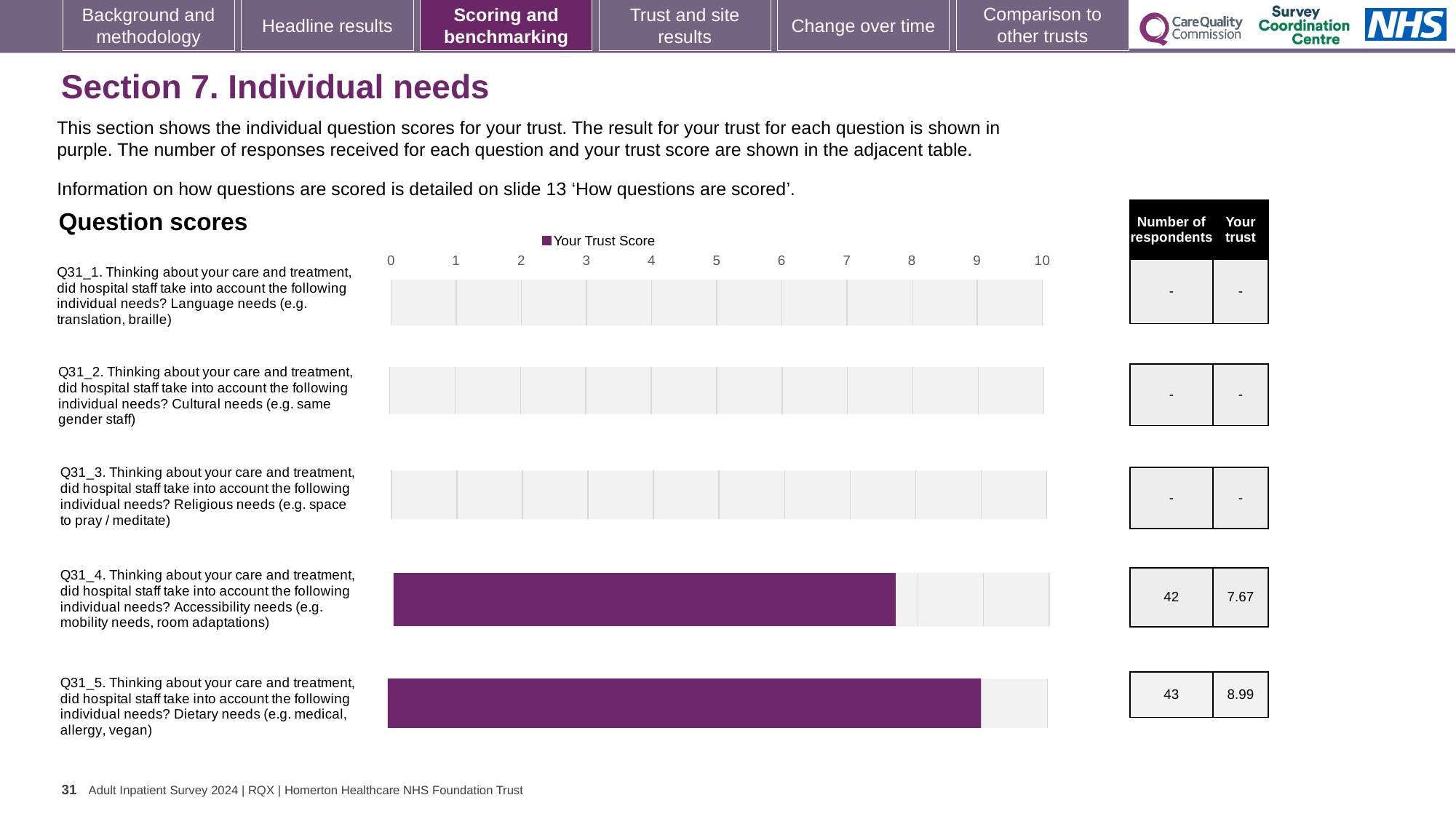
How many questions are listed on the chart? 5 What is the trust score for Q31_4 (Accessibility needs)? 7.67 What is the trust score for Q31_5 (Dietary needs)? 8.99 How many respondents answered Q31_5 (Dietary needs)? 43 What series does the chart legend list? Your Trust Score Is the trust score for Q31_4 (Accessibility needs) greater or less than 8? less What is the difference between the trust scores for Q31_5 and Q31_4? 1.32 Which question has the highest trust score shown on the chart? Q31_5 (Dietary needs) What kind of chart is shown on the slide? Bar chart Is the trust score for Q31_5 (Dietary needs) greater or less than 8? greater How many respondents answered Q31_4 (Accessibility needs)? 42 Which has the larger trust score, Q31_4 (Accessibility needs) or Q31_5 (Dietary needs)? Q31_5 (Dietary needs)